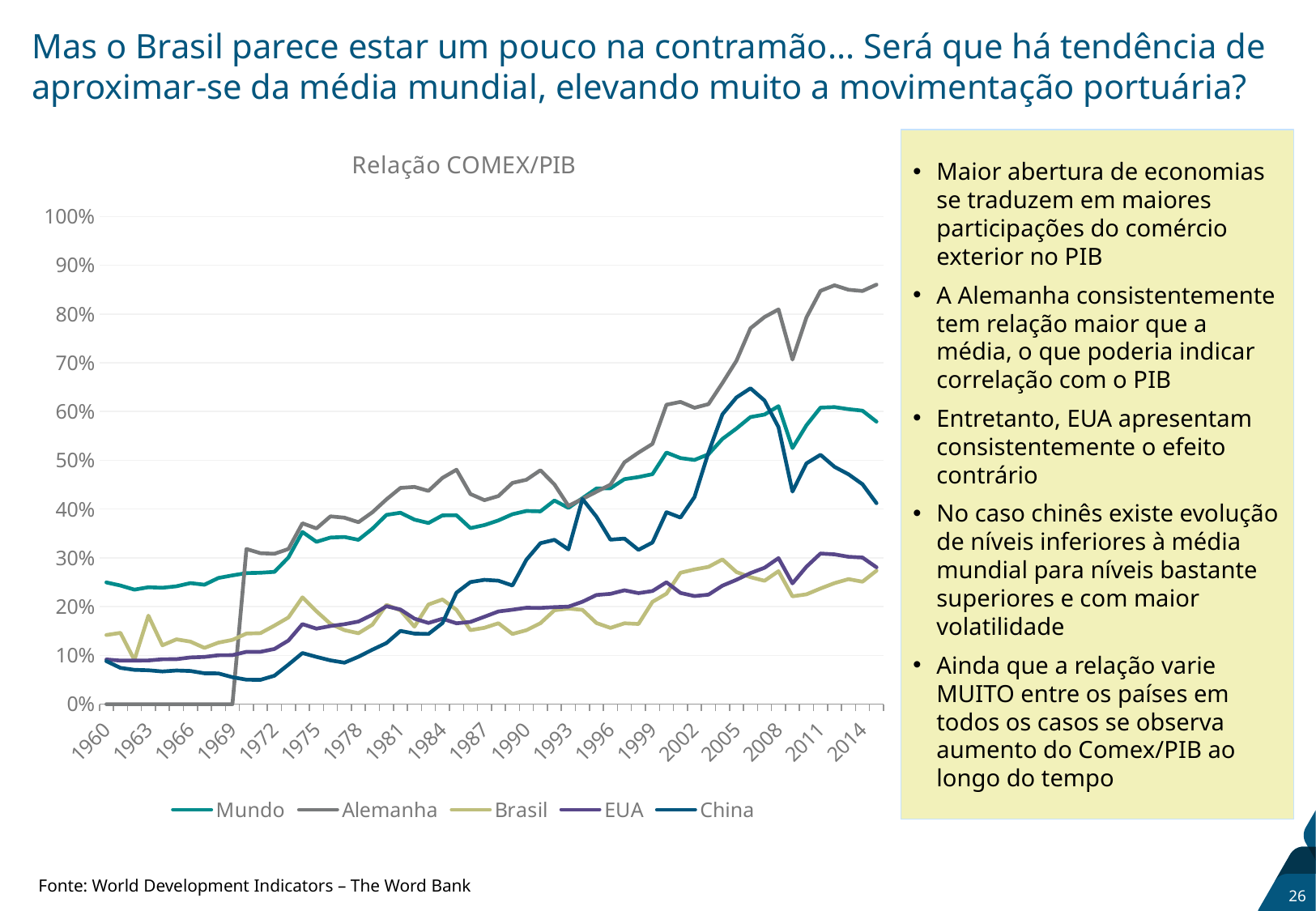
Is the value for Brasil in 2014 greater or less than 40%? less Is the value for Alemanha in 2014 greater or less than 80%? greater Which series are listed in the chart legend? Mundo, Alemanha, Brasil, EUA, China What is the title of the chart? Relação COMEX/PIB What kind of chart is shown on the slide? Line chart Which series has the highest value at the right end of the chart (2014)? Alemanha Is the value for China in 2014 greater or less than 50%? less Does the Alemanha series generally rise or fall from 1970 to 2014? Rise How many series does the legend of the chart list? 5 In 2014, which is larger: the value for China or the value for Brasil? China